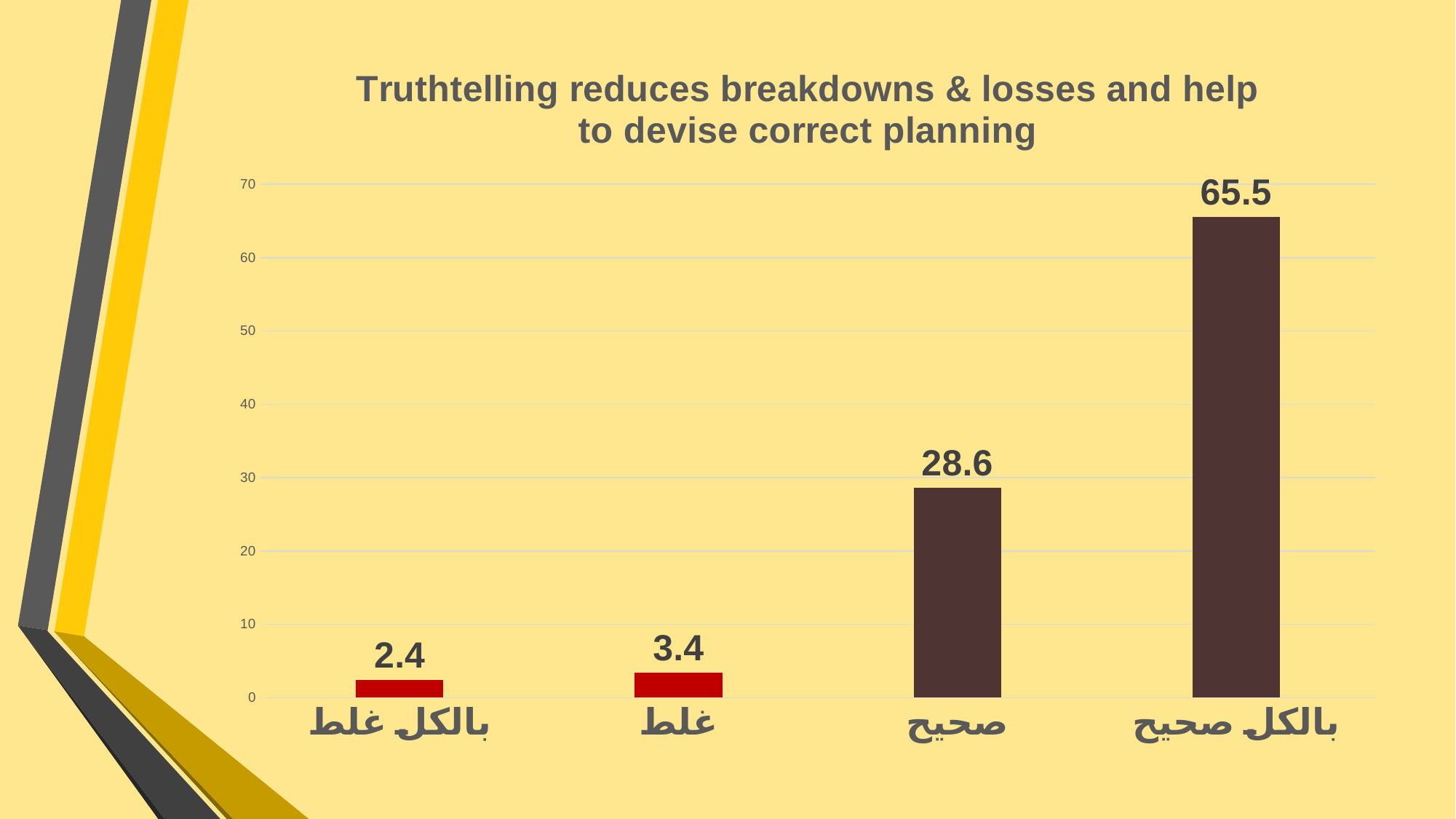
What is the value for "غلط"? 3.4 What is the difference between the values for "غلط" and "بالكل غلط"? 1 What is the value for "بالكل غلط"? 2.4 What kind of chart is shown on the slide? bar chart Which category has the highest value? بالكل صحيح Which category has the lowest value? بالكل غلط What is the value for "بالكل صحيح"? 65.5 How many categories are shown on the x axis? 4 What is the difference between the values for "بالكل صحيح" and "صحيح"? 36.9 Which is larger, the value for "صحيح" or the value for "غلط"? صحيح Is the value for "بالكل صحيح" greater or less than 60? greater What is the value for "صحيح"? 28.6